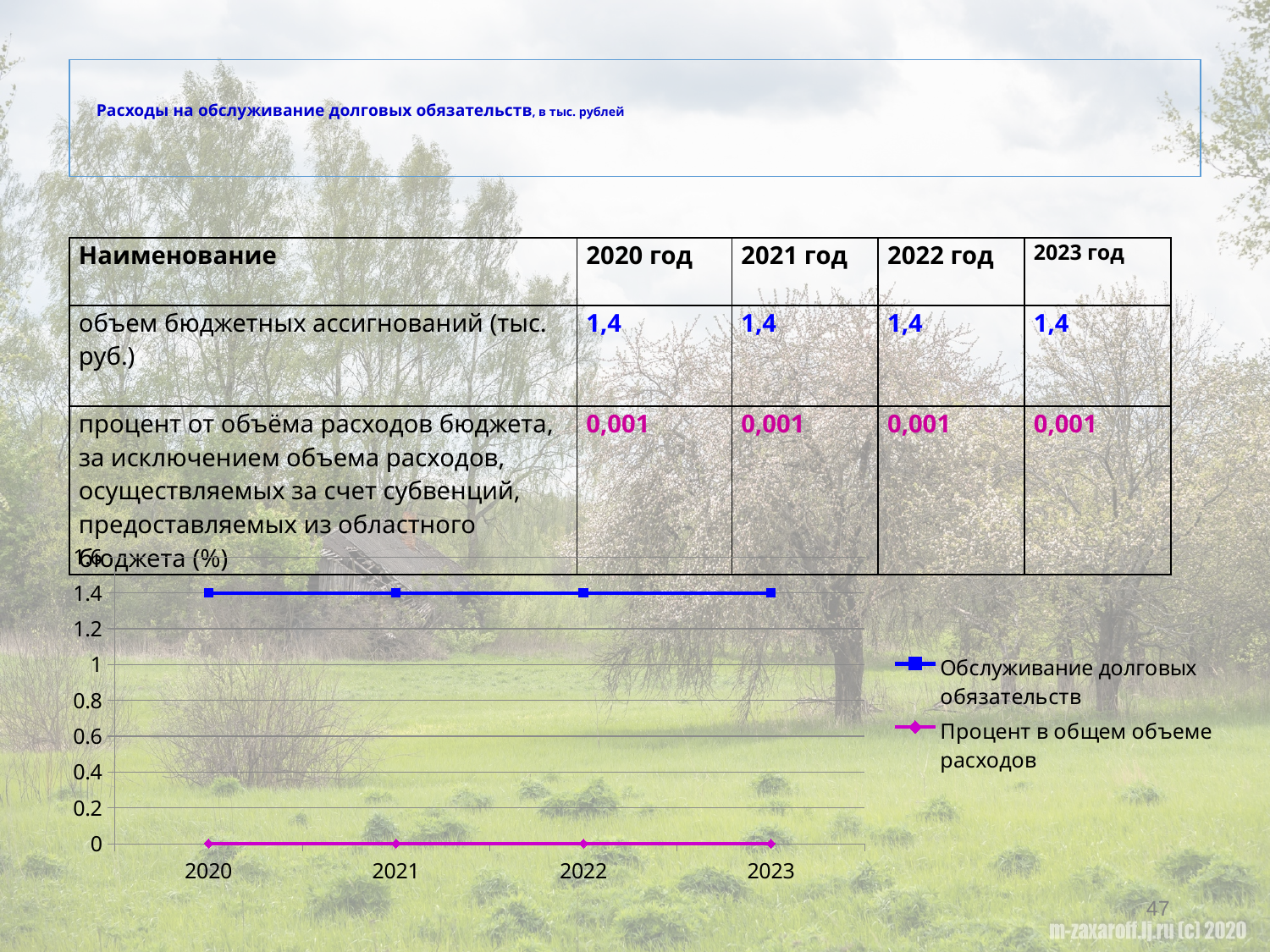
What kind of chart is shown on the slide? line chart Is the value of 'Обслуживание долговых обязательств' for 2022 greater or less than 1? greater How many years are shown along the x axis of the chart? 4 What is the difference between the 'Обслуживание долговых обязательств' values for 2020 and 2023? 0 What colour is the line for 'Процент в общем объеме расходов' on the chart? magenta What is the highest value shown on the chart's y axis? 1.6 What is the value of the 'Обслуживание долговых обязательств' series for 2023 on the chart? 1.4 How many series does the chart legend list? 2 Is the value of 'Процент в общем объеме расходов' for 2021 greater or less than 0.2? less What is the value of the 'Обслуживание долговых обязательств' series for 2020 on the chart? 1.4 Which series has the higher value in 2023, 'Обслуживание долговых обязательств' or 'Процент в общем объеме расходов'? Обслуживание долговых обязательств Does the 'Обслуживание долговых обязательств' line rise, fall or stay flat from 2020 to 2023? stays flat